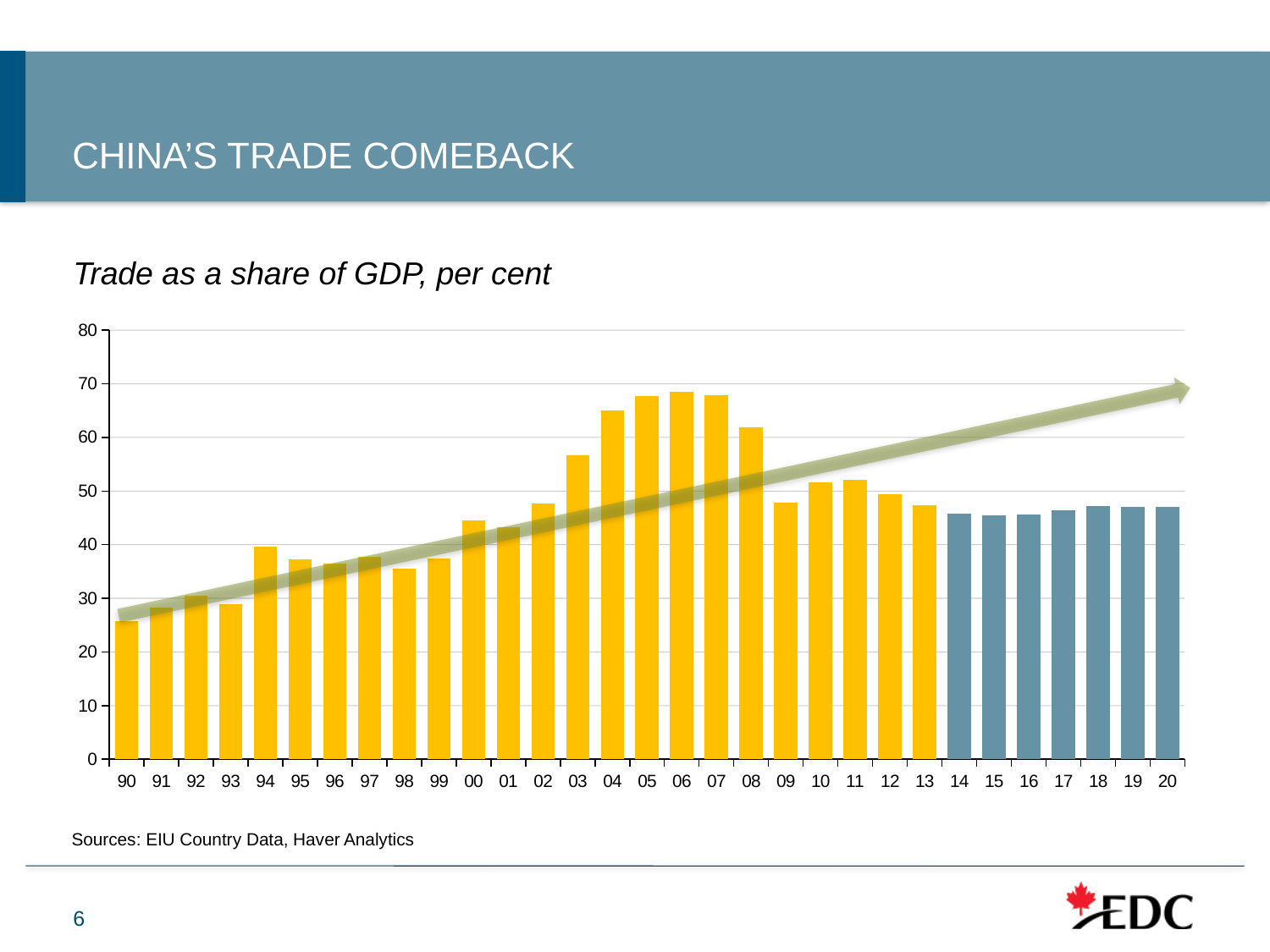
Which is larger, the value for 05 or the value for 08? 05 Is the value for 13 greater or less than 50? less Which year has the lowest trade as a share of GDP? 90 Which year has the highest trade as a share of GDP? 06 Is the value for 03 greater or less than 50? greater Is the value for 06 greater or less than 60? greater What kind of chart is shown on the slide? bar chart Do the values rise or fall from 90 to 06? rise What is the title of the chart? Trade as a share of GDP, per cent Which is larger, the value for 10 or the value for 14? 10 How many years (bars) are plotted on the chart? 31